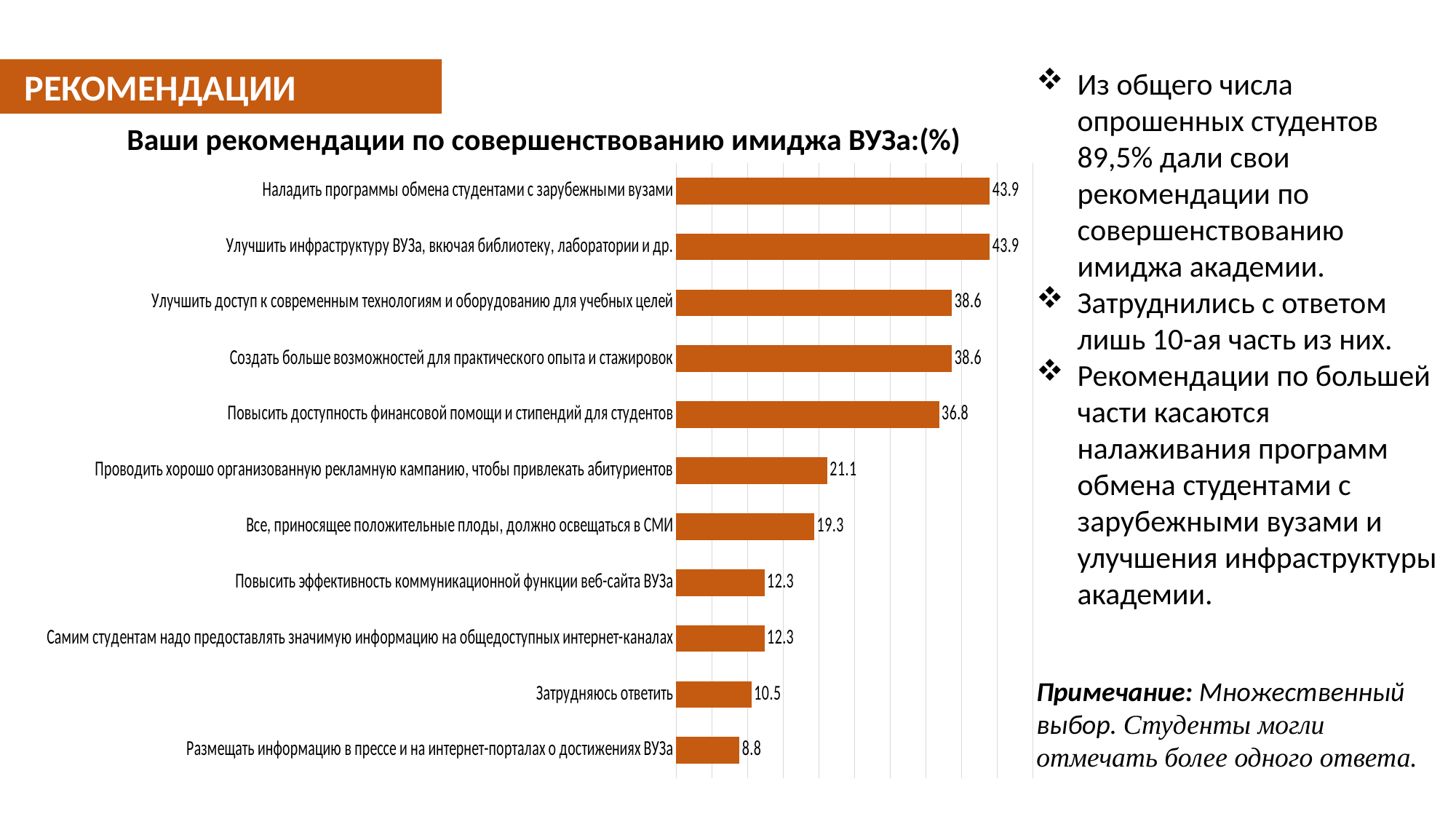
What is the highest value shown in the chart? 43.9 How many categories are shown in the chart? 11 What value is shown for "Все, приносящее положительные плоды, должно освещаться в СМИ"? 19.3 What type of chart is shown on the slide? Bar chart What value is shown for "Затрудняюсь ответить"? 10.5 Which is larger: the value for "Улучшить доступ к современным технологиям и оборудованию для учебных целей" or the value for "Повысить доступность финансовой помощи и стипендий для студентов"? Улучшить доступ к современным технологиям и оборудованию для учебных целей What value is shown for "Повысить доступность финансовой помощи и стипендий для студентов"? 36.8 What is the difference between the values for "Наладить программы обмена студентами с зарубежными вузами" and "Размещать информацию в прессе и на интернет-порталах о достижениях ВУЗа"? 35.1 What is the title of the chart? Ваши рекомендации по совершенствованию имиджа ВУЗа:(%) What value is shown for "Наладить программы обмена студентами с зарубежными вузами"? 43.9 Which category has the lowest value in the chart? Размещать информацию в прессе и на интернет-порталах о достижениях ВУЗа What is the difference between the values for "Проводить хорошо организованную рекламную кампанию, чтобы привлекать абитуриентов" and "Все, приносящее положительные плоды, должно освещаться в СМИ"? 1.8